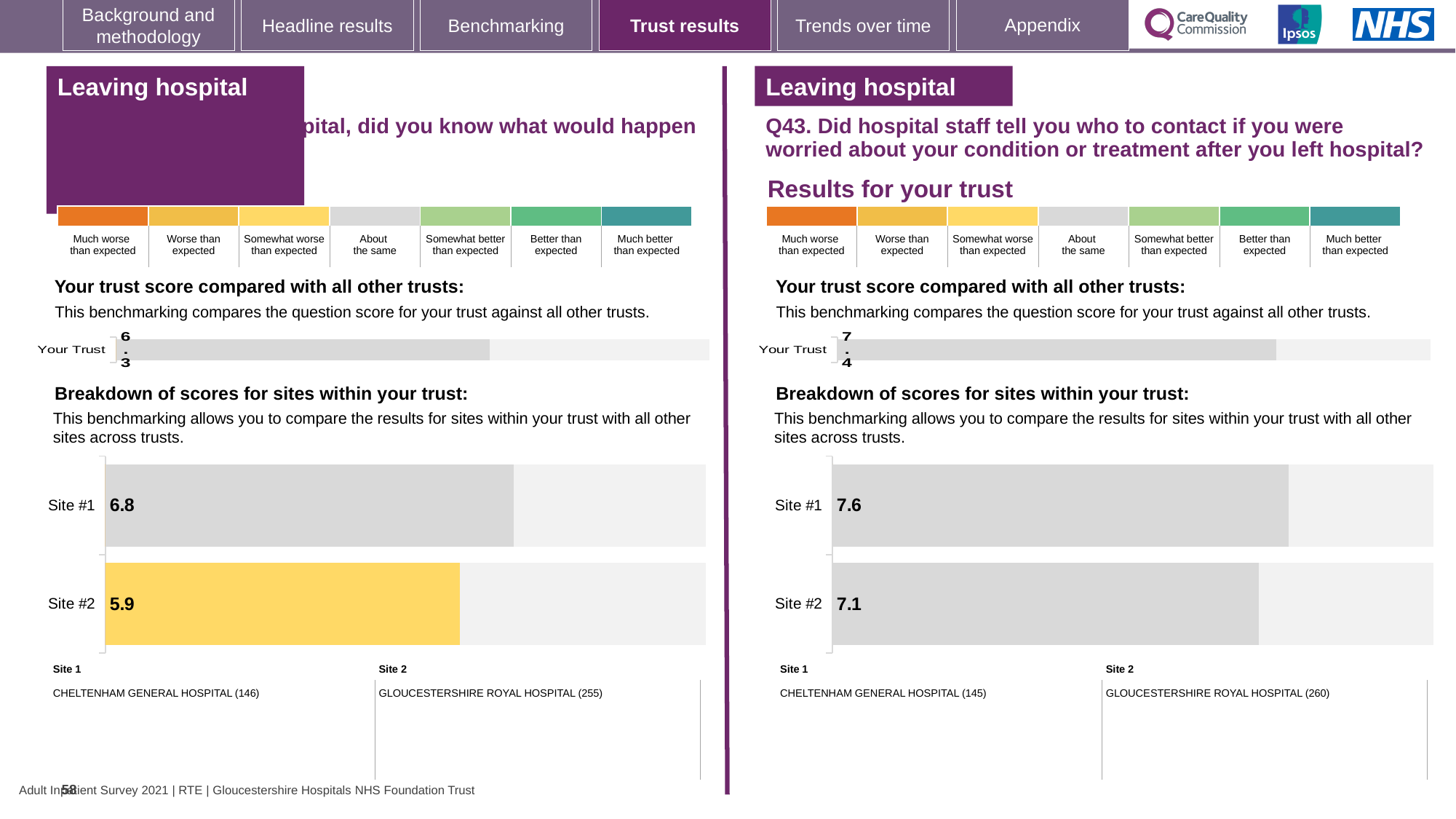
In the 'Your trust score compared with all other trusts' chart on the left half of the slide, what is the score shown for Your Trust? 6.3 In the site breakdown chart on the left half of the slide, what is the difference between the Site #1 and Site #2 scores? 0.9 In the site breakdown chart for Q43 on the right half of the slide, what is the score for Site #1? 7.6 In the site breakdown chart on the left half of the slide, what is the score for Site #2? 5.9 In the site breakdown chart on the left half of the slide, which site has the higher score? Site #1 How many sites are plotted in the site breakdown chart for Q43 on the right half of the slide? 2 In the site breakdown chart for Q43 on the right half of the slide, what is the score for Site #2? 7.1 What type of chart is used to show the breakdown of scores for sites on the left half of the slide? Bar chart In the 'Your trust score compared with all other trusts' chart for Q43 on the right half of the slide, what is the score shown for Your Trust? 7.4 In the site breakdown chart on the left half of the slide, what is the score for Site #1? 6.8 In the site breakdown chart for Q43 on the right half of the slide, which site has the lower score? Site #2 In the site breakdown chart for Q43 on the right half of the slide, what is the difference between the Site #1 and Site #2 scores? 0.5